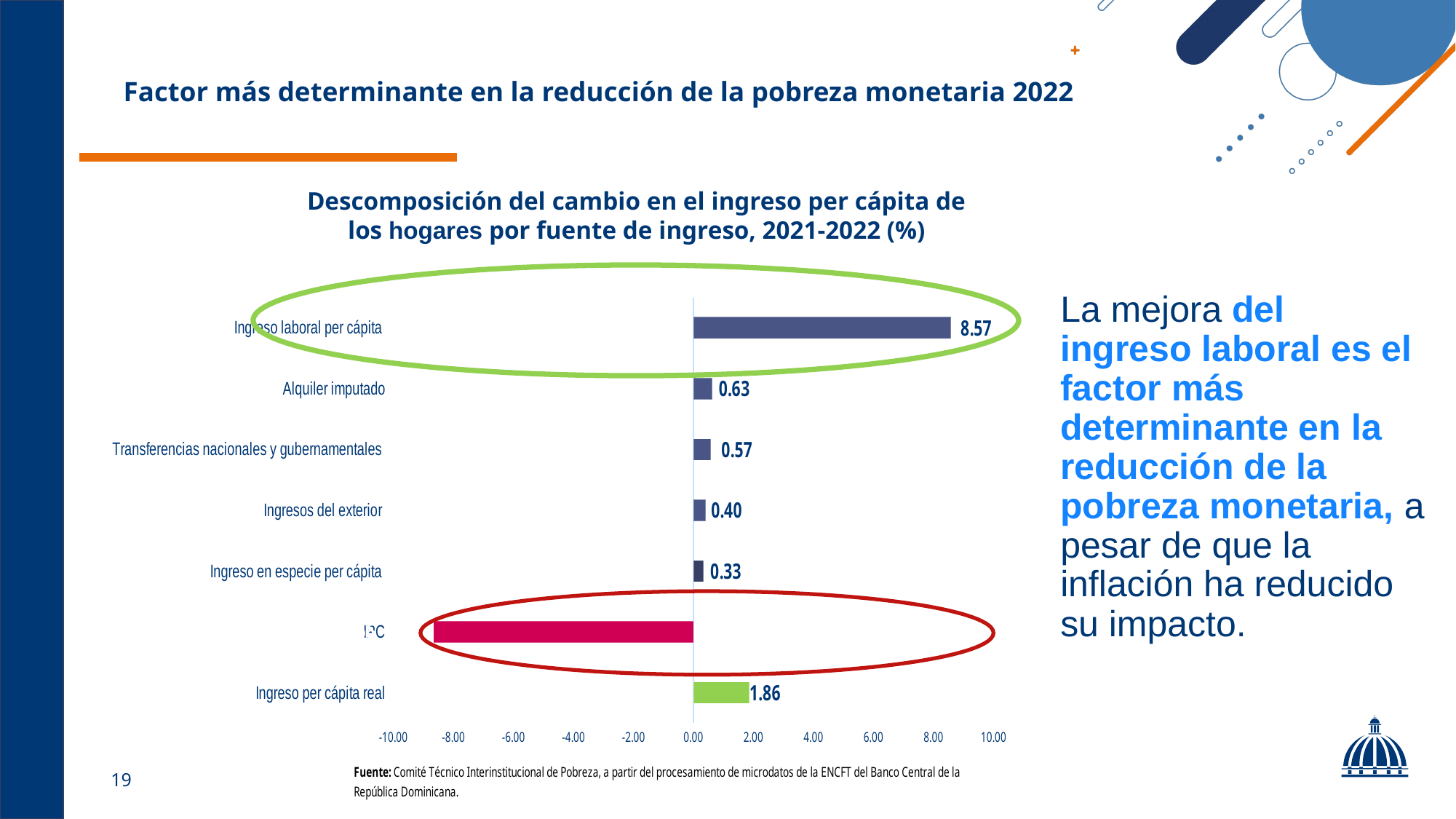
What is the value for Ingreso per cápita real? 1.86 Which category has the highest value? Ingreso laboral per cápita Which is larger, the value for Transferencias nacionales y gubernamentales or the value for Ingresos del exterior? Transferencias nacionales y gubernamentales Is the value for IPC greater or less than -6.00? less What is the title of the chart? Descomposición del cambio en el ingreso per cápita de los hogares por fuente de ingreso, 2021-2022 (%) What is the value for Ingreso en especie per cápita? 0.33 What is the value for Ingreso laboral per cápita? 8.57 What is the difference between the values for Ingreso laboral per cápita and Alquiler imputado? 7.94 What is the value for Alquiler imputado? 0.63 How many categories are shown in the chart? 7 What kind of chart is shown on the slide? Bar chart Which category has the lowest value? IPC